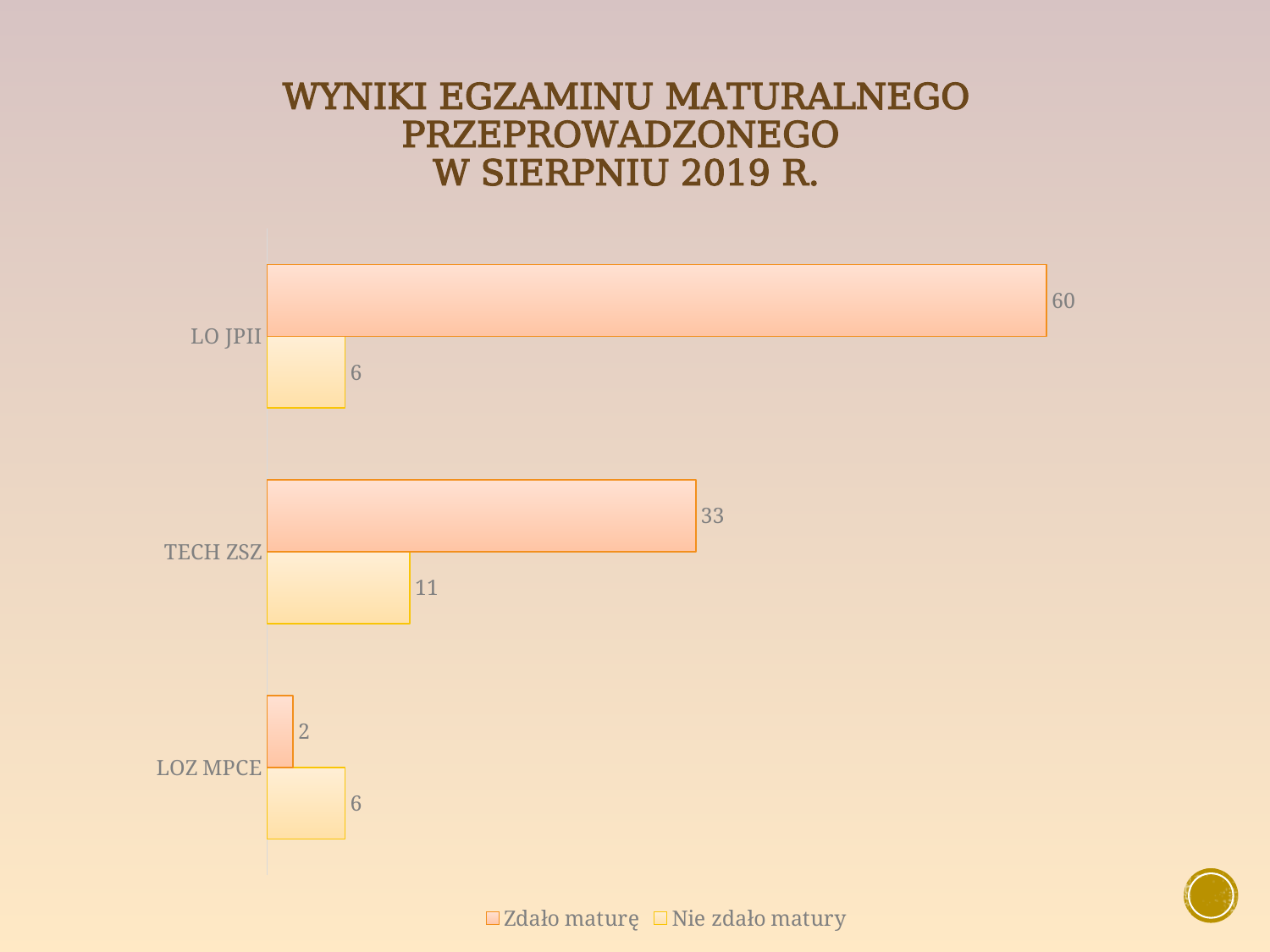
What kind of chart is shown on the slide? Bar chart For LOZ MPCE, which is larger: "Zdało maturę" or "Nie zdało matury"? Nie zdało matury How many series does the legend list? 2 What is the value of "Zdało maturę" for LOZ MPCE? 2 What are the two series named in the legend? Zdało maturę and Nie zdało matury Which category has the lowest value for "Zdało maturę"? LOZ MPCE What is the value of "Nie zdało matury" for TECH ZSZ? 11 How many categories are shown on the chart? 3 What is the difference between the "Zdało maturę" values for LO JPII and TECH ZSZ? 27 What is the value of "Nie zdało matury" for LO JPII? 6 Which category has the highest value for "Zdało maturę"? LO JPII What is the value of "Zdało maturę" for LO JPII? 60